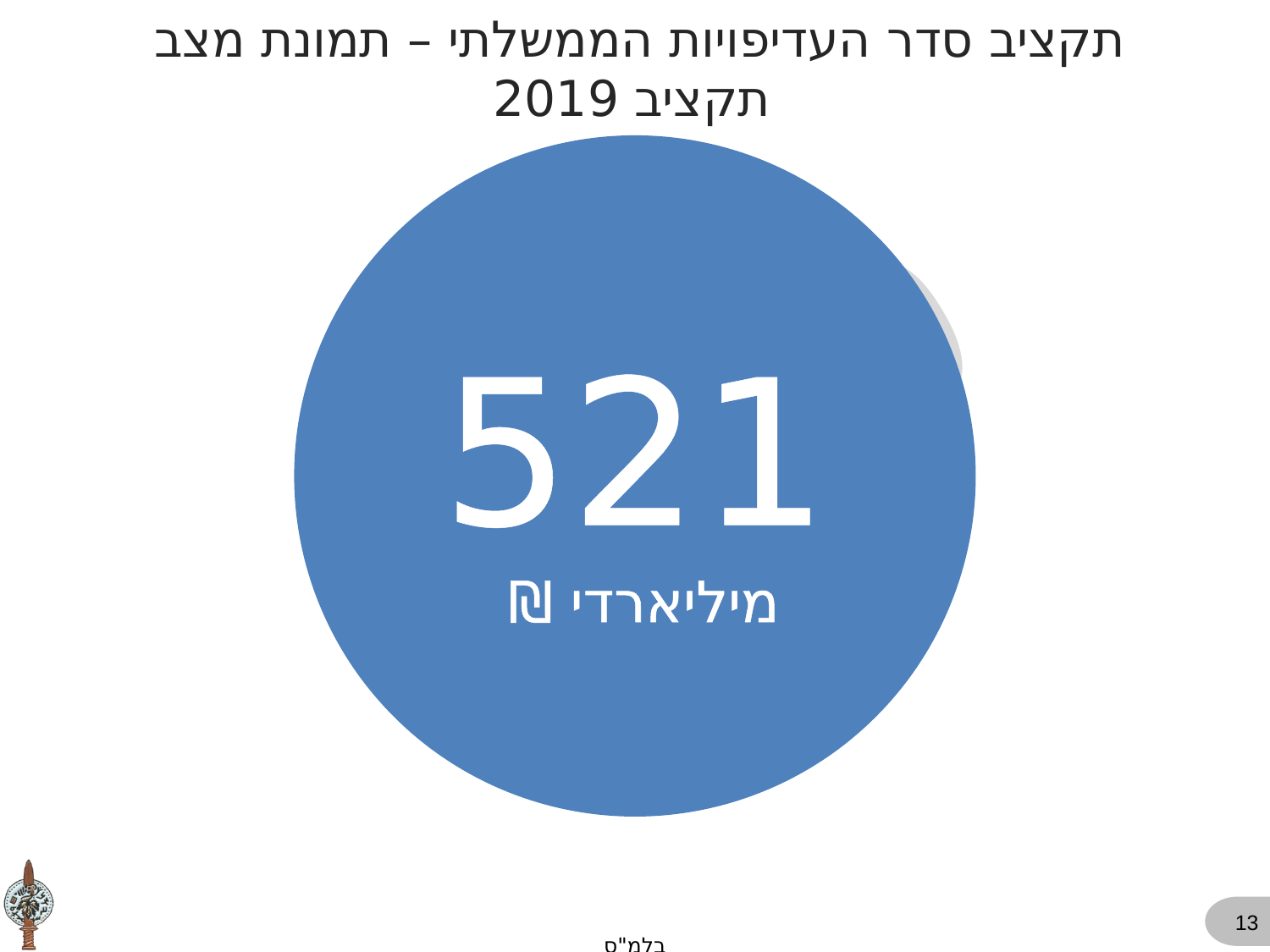
Which budget year does the slide title refer to? 2019 What unit is written beneath the number 521 in the blue circle? מיליארדי ₪ Is the value shown in the blue circle greater or less than 500? greater What number is displayed in the large blue circle on the slide? 521 What is the total budget figure shown on the slide, including its unit? 521 מיליארדי ₪